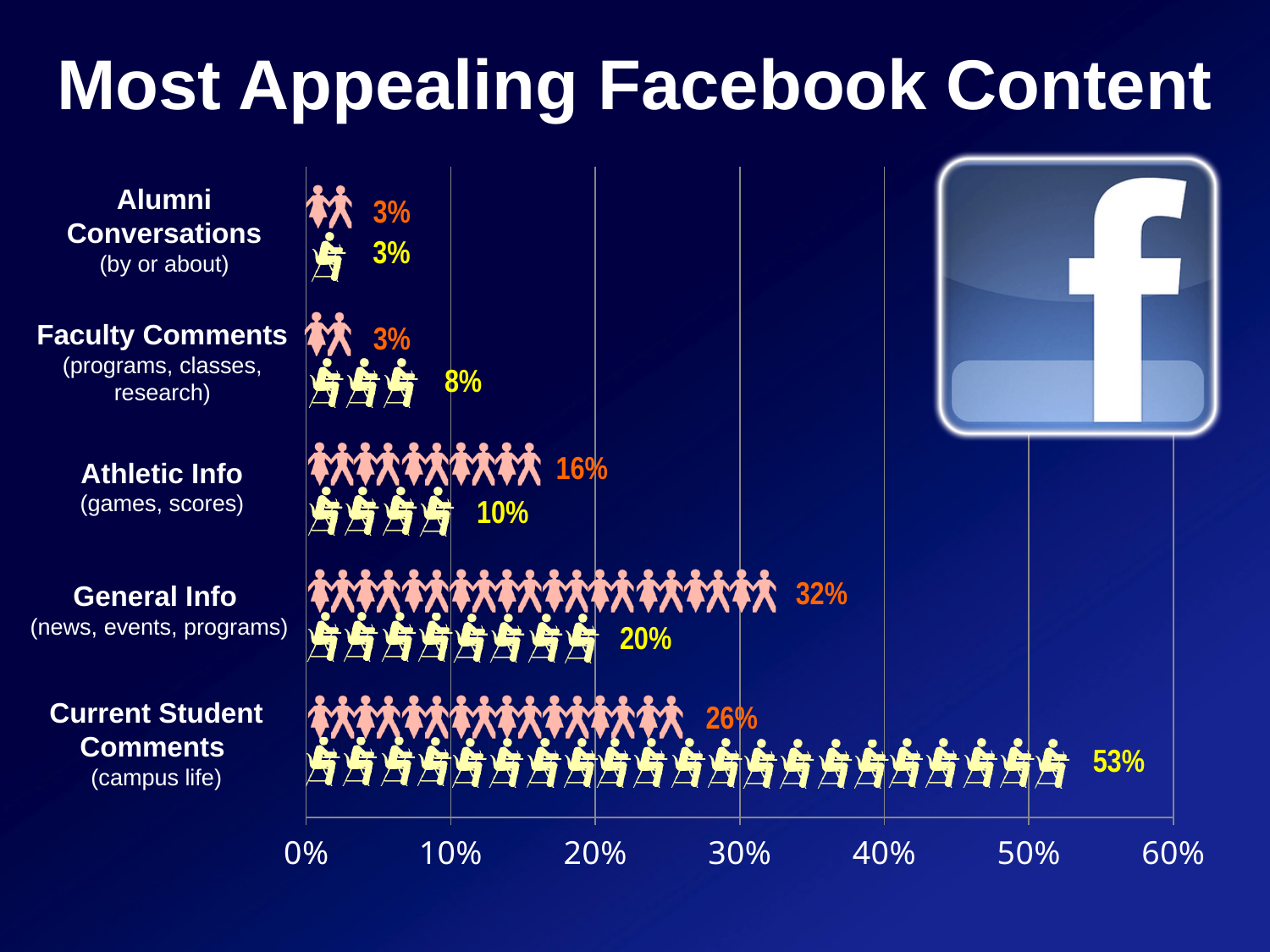
Is the yellow seated-figure value for Current Student Comments greater or less than 50%? greater What is the title of the slide? Most Appealing Facebook Content What kind of chart is shown on the slide? Bar chart (pictograph) Which category has the highest value in the pink standing-figure series? General Info What is the value shown by the yellow seated-figure row for Faculty Comments? 8% What is the value shown by the pink standing-figure row for Athletic Info? 16% Which category has the highest value on the chart? Current Student Comments What is the value shown by the yellow seated-figure row for Current Student Comments? 53% How many content categories are shown on the chart? 5 What is the value shown by the pink standing-figure row for General Info? 32% What is the difference between the pink standing-figure value and the yellow seated-figure value for General Info? 12% For Current Student Comments, which is larger: the pink standing-figure value or the yellow seated-figure value? The yellow seated-figure value